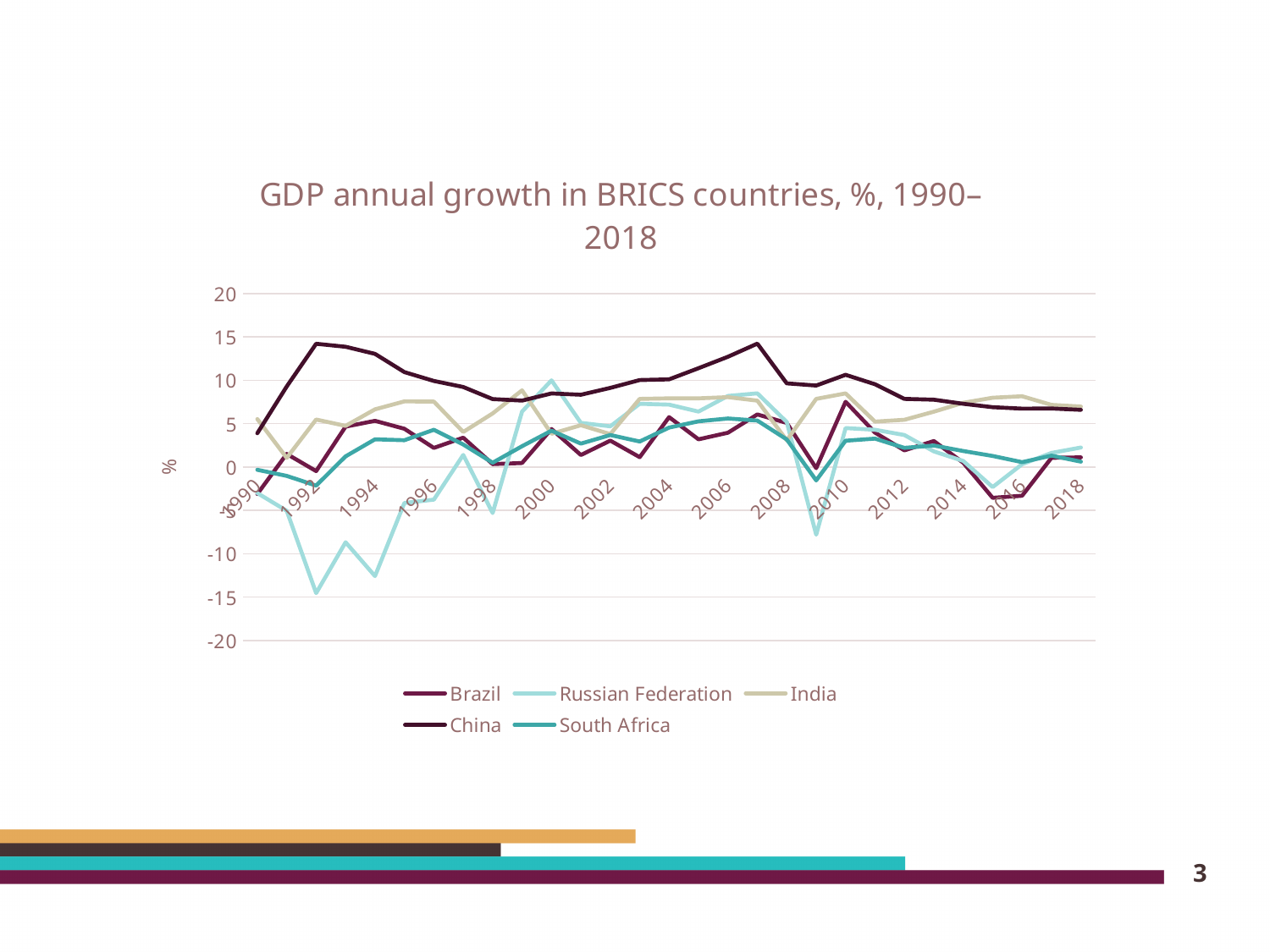
What is the title of the chart? GDP annual growth in BRICS countries, %, 1990–2018 Is the value for Brazil in 2016 greater or less than 0? less What kind of chart is shown on the slide? line chart How many series does the legend list? 5 Which series has the highest value in 1992? China Is the value for China in 1992 greater or less than 10? greater Which series has the lowest value in 1992? Russian Federation Is the value for the Russian Federation in 2009 greater or less than -5? less What label is shown on the vertical axis? % Which series has the lowest value in 2009? Russian Federation Which is larger in 1998, the value for India or the value for the Russian Federation? India